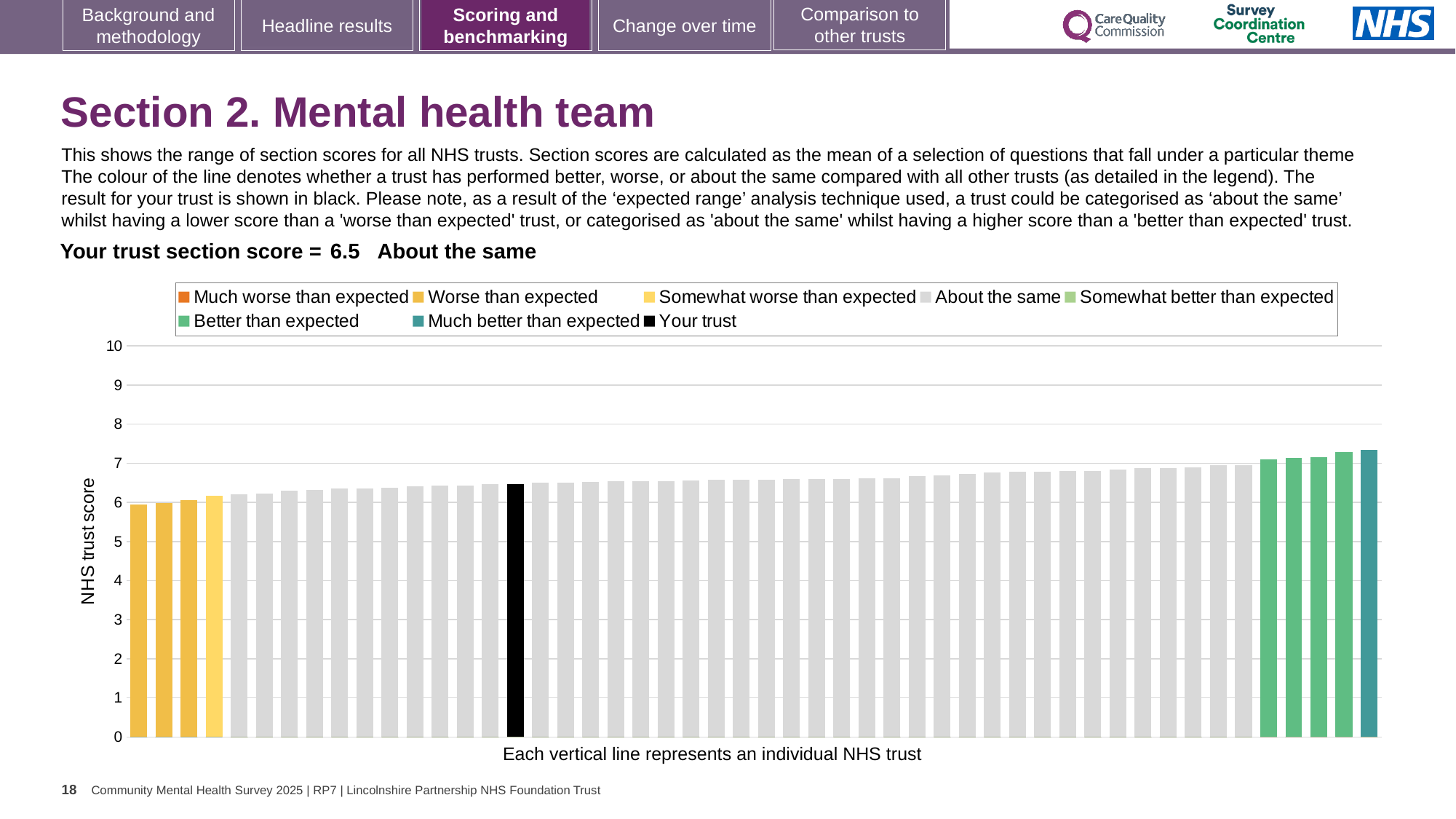
Is the value of the leftmost bar greater or less than 5? greater What kind of chart is shown on the slide? bar chart What is the section score for your trust shown on the slide? 6.5 Do the bar values rise or fall from left to right along the x axis? rise How many bars are coloured as 'Much better than expected'? 1 What is the label on the vertical axis of the chart? NHS trust score Which category is your trust placed in for this section? About the same Is the value of the rightmost bar greater or less than 7? greater Is the value of the black 'Your trust' bar greater or less than 7? less Which legend category does the highest bar belong to? Much better than expected How many entries does the chart legend list? 8 Which is larger, the leftmost bar or the rightmost bar? the rightmost bar